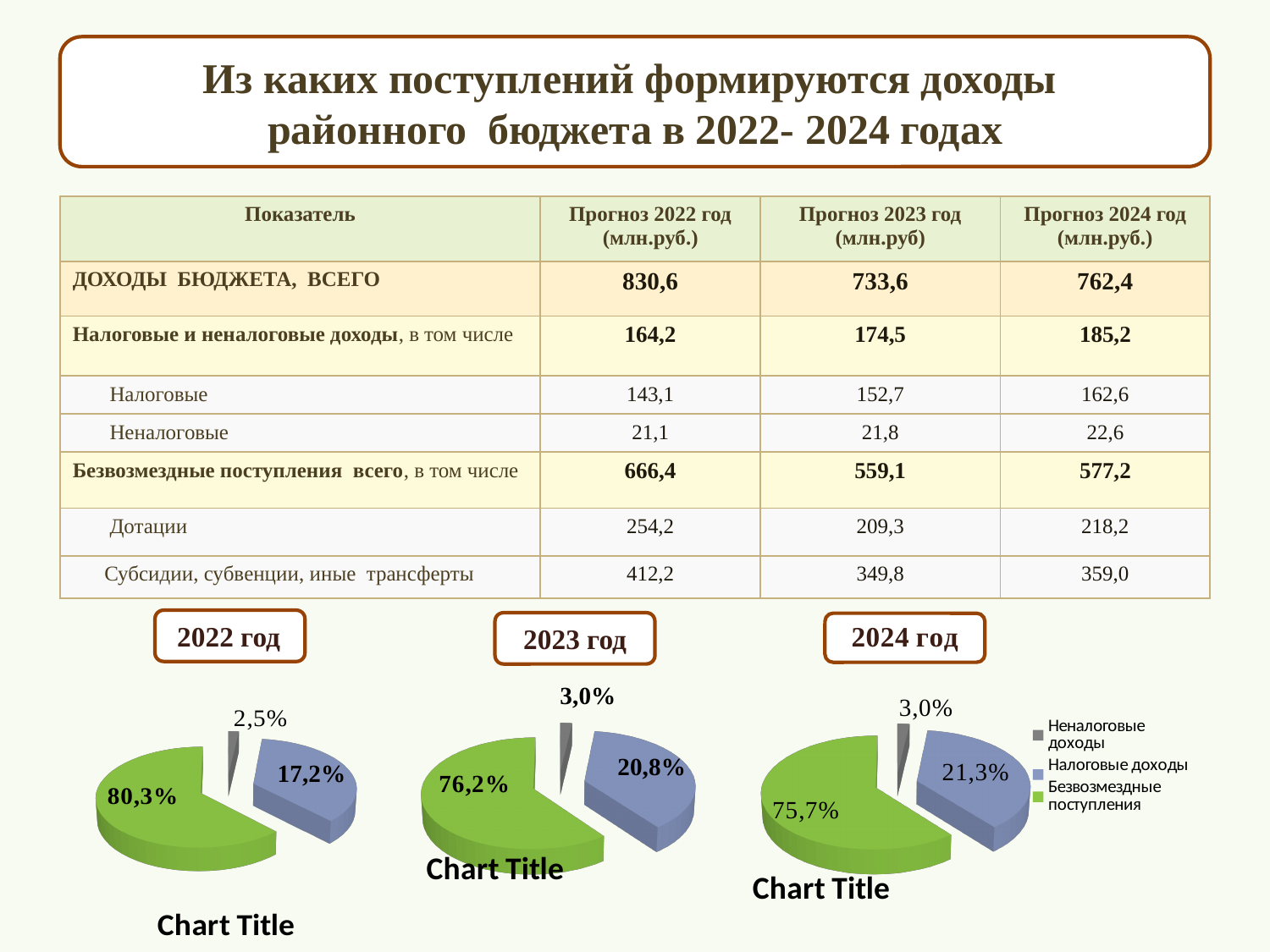
In the 2024 год pie chart, which category has the largest share? Безвозмездные поступления In the 2023 год pie chart, what is the difference between the green slice (76,2%) and the blue slice (20,8%)? 55,4 percentage points In the 2023 год pie chart, what share is shown for the grey slice (Неналоговые доходы)? 3,0% How many entries does the legend next to the 2024 год chart list? 3 What type of chart is used for the 2022 год, 2023 год and 2024 год data? Pie chart In the legend next to the 2024 год chart, which colour represents Безвозмездные поступления? Green In the 2022 год pie chart, what share is shown for the green slice (Безвозмездные поступления)? 80,3% In the 2022 год pie chart, what share is shown for the blue slice (Налоговые доходы)? 17,2% In the 2022 год pie chart, which slice is the smallest? Неналоговые доходы (2,5%) In the 2024 год pie chart, what share is shown for Налоговые доходы? 21,3% How many slices does the 2023 год pie chart have? 3 Which is larger: the Налоговые доходы share in the 2022 год chart or in the 2024 год chart? 2024 год (21,3%)